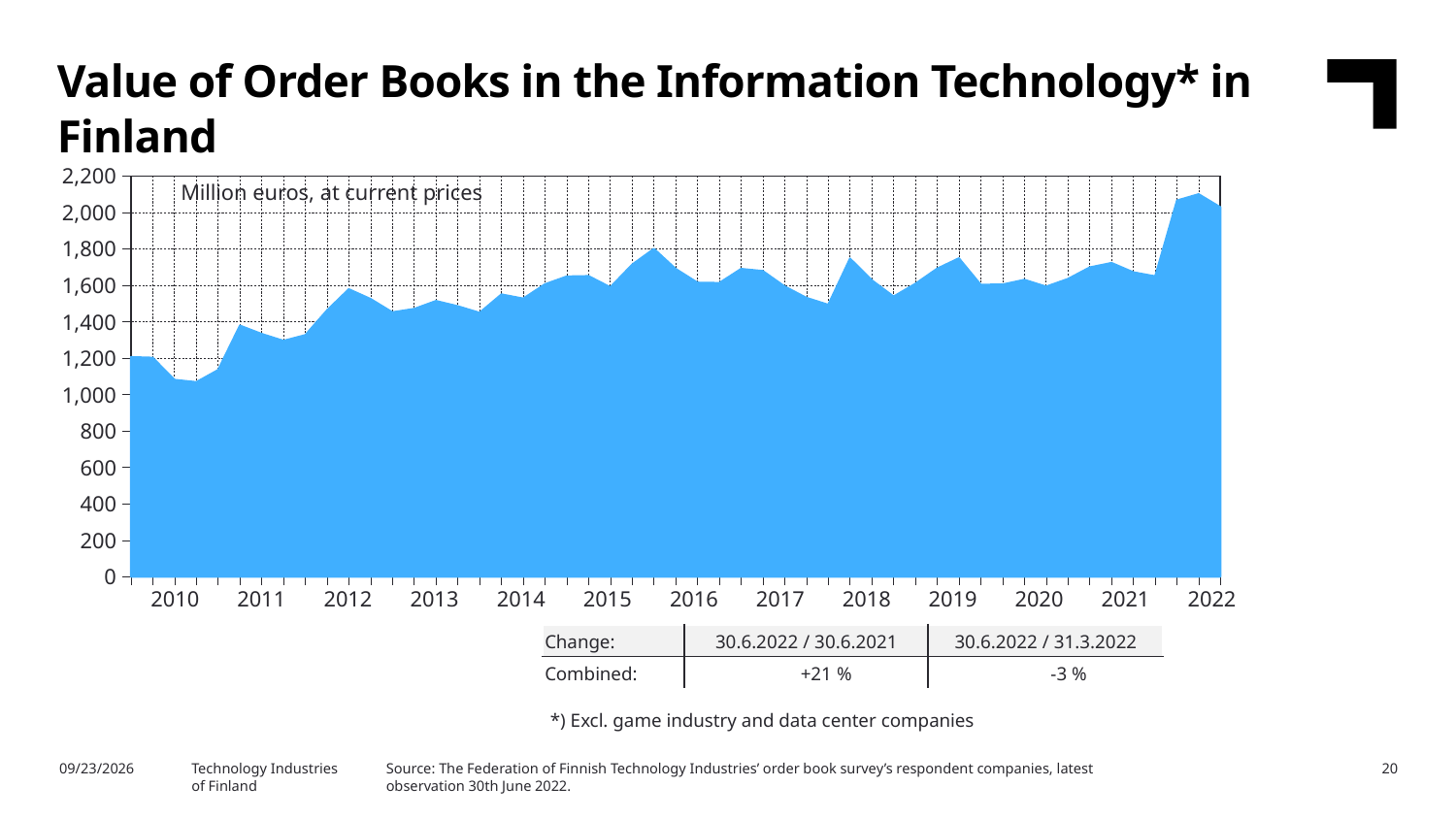
Is the value of order books higher in 2022 or in 2010? 2022 What unit is the chart's data expressed in, according to the label inside the plot area? Million euros, at current prices Is the value at the start of 2014 greater or less than 1,400? greater Is the peak value in 2022 greater or less than 2,000? greater What is the title of the chart? Value of Order Books in the Information Technology* in Finland In which year does the value of order books reach its lowest level? 2010 Overall, do the values rise or fall from 2010 to 2022? rise In which year does the value of order books reach its highest level? 2022 How many years are labeled on the x axis? 13 What kind of chart is shown on the slide? area chart Is the value at the start of 2018 greater or less than 1,600? greater